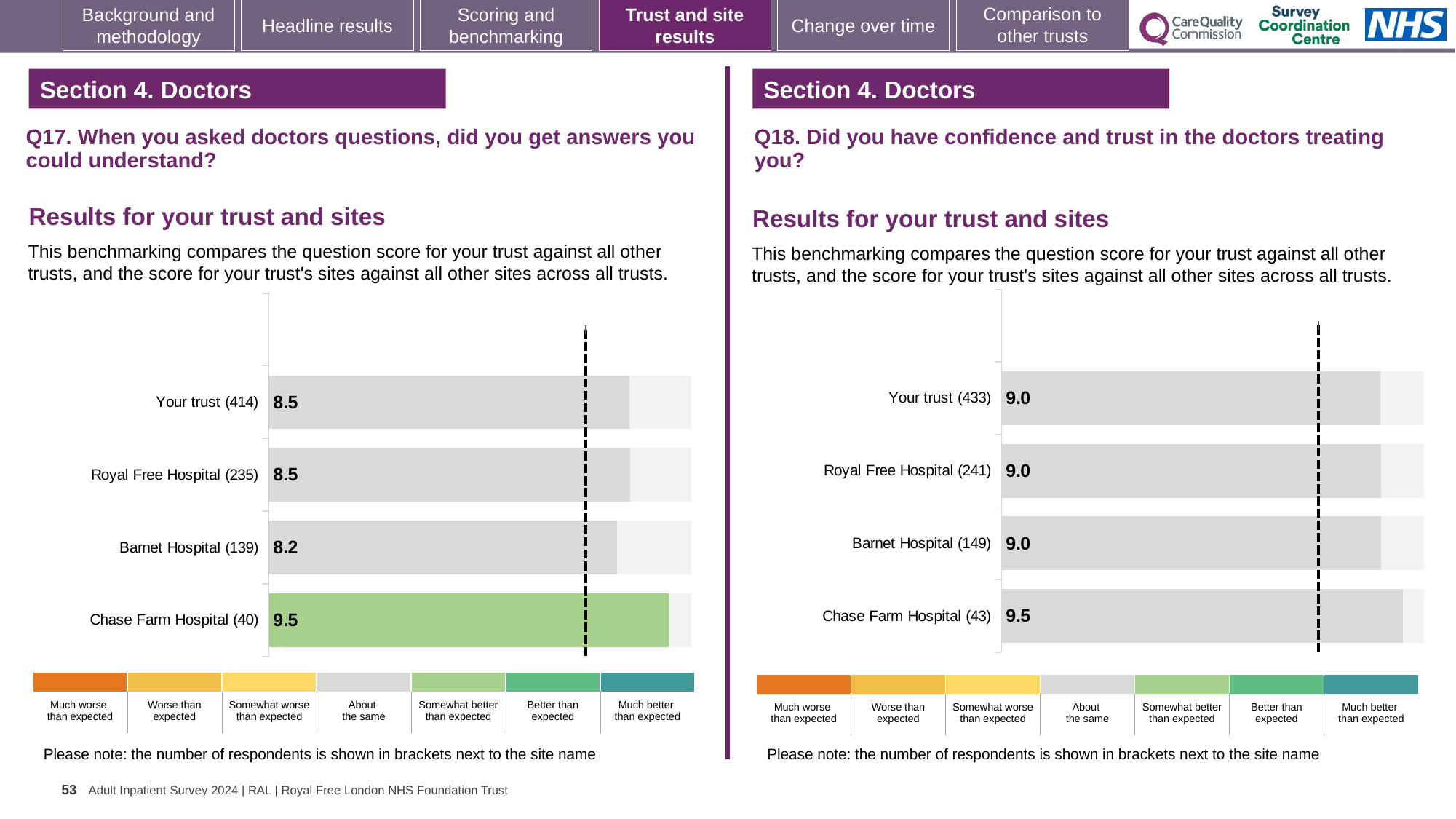
On the Q18 chart (right), which site or trust has the highest score? Chase Farm Hospital On the Q17 chart (left), which bar is coloured green rather than grey? Chase Farm Hospital On the Q18 chart (right), what is the difference between the Chase Farm Hospital score and the Royal Free Hospital score? 0.5 On the Q17 chart (left), which site or trust has the highest score? Chase Farm Hospital On the Q17 chart (left), what is the score for Barnet Hospital? 8.2 On the Q17 chart (left), what is the difference between the Chase Farm Hospital score and the Barnet Hospital score? 1.3 What kind of chart is used on the Q17 chart (left)? Bar chart On the Q17 chart (left), how many bars are plotted? 4 On the Q17 chart (left), what is the score for Chase Farm Hospital? 9.5 On the Q17 chart (left), which site or trust has the lowest score? Barnet Hospital On the Q18 chart (right), what is the score for Chase Farm Hospital? 9.5 On the Q18 chart (right), what is the score for Your trust? 9.0